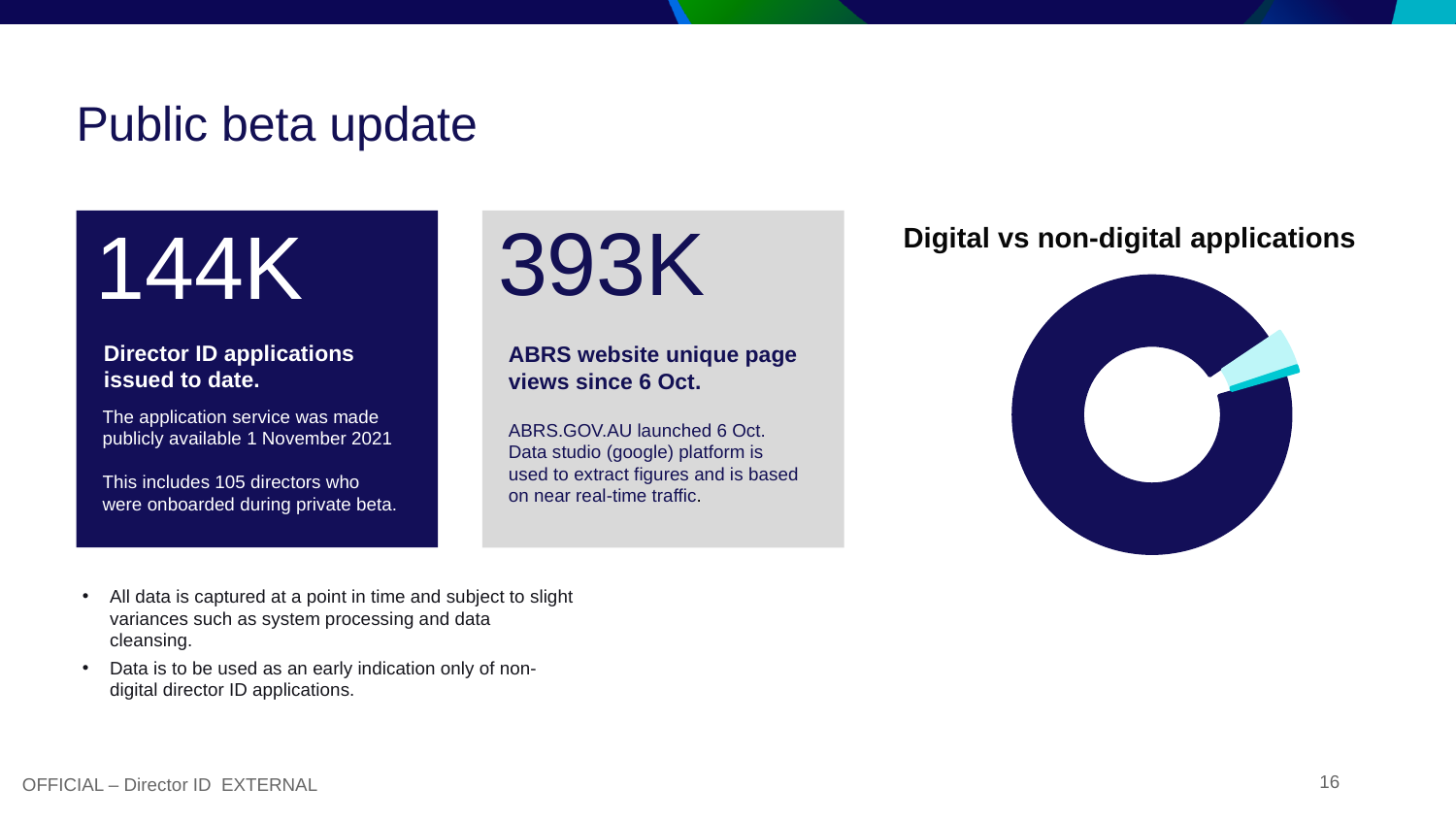
In the "Digital vs non-digital applications" chart, which slice is pulled out (exploded) from the ring? The light cyan and thin teal slices (both small slices) What kind of chart is shown under the title "Digital vs non-digital applications"? Donut chart In the "Digital vs non-digital applications" chart, which slice is larger, the dark navy slice or the light cyan slice? The dark navy slice How many slices does the "Digital vs non-digital applications" donut chart have? 3 In the "Digital vs non-digital applications" chart, which slice is the smallest? The thin teal slice What is the title of the chart on the right side of the slide? Digital vs non-digital applications